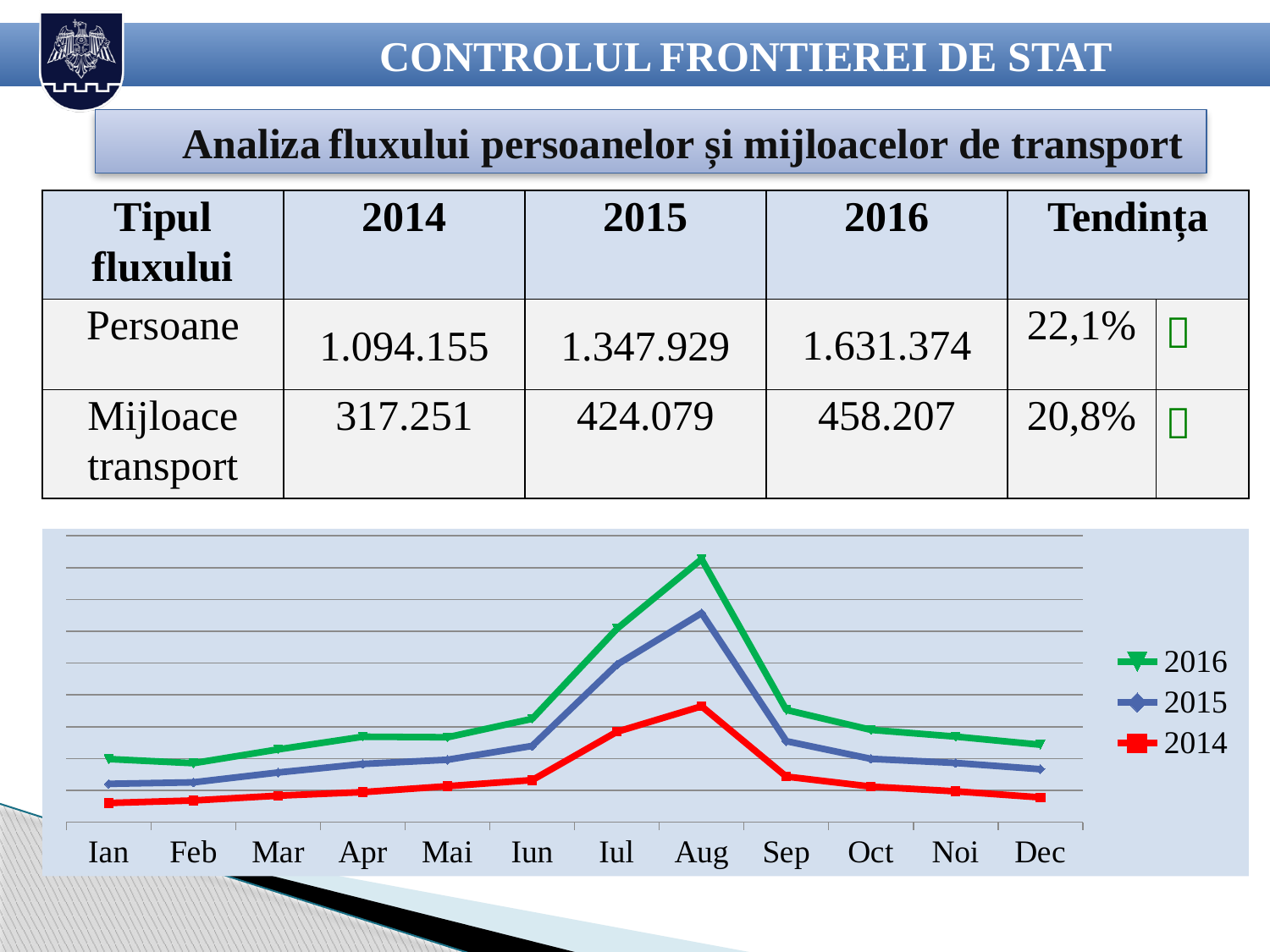
In which month does the 2014 series reach its highest value? Aug Do the values of the 2016 series rise or fall from Aug to Dec? fall What kind of chart is shown at the bottom of the slide? line chart In Aug, which series has the higher value, 2016 or 2014? 2016 In Iul, which series has the higher value, 2015 or 2014? 2015 In which month does the 2015 series reach its highest value? Aug Which colour is used for the 2014 series in the line chart? red How many months are shown on the x axis of the line chart? 12 In which month is the 2016 series at its lowest value? Feb Which series are listed in the legend of the line chart? 2016, 2015, 2014 How many series does the legend of the line chart list? 3 In which month does the 2016 series reach its highest value? Aug